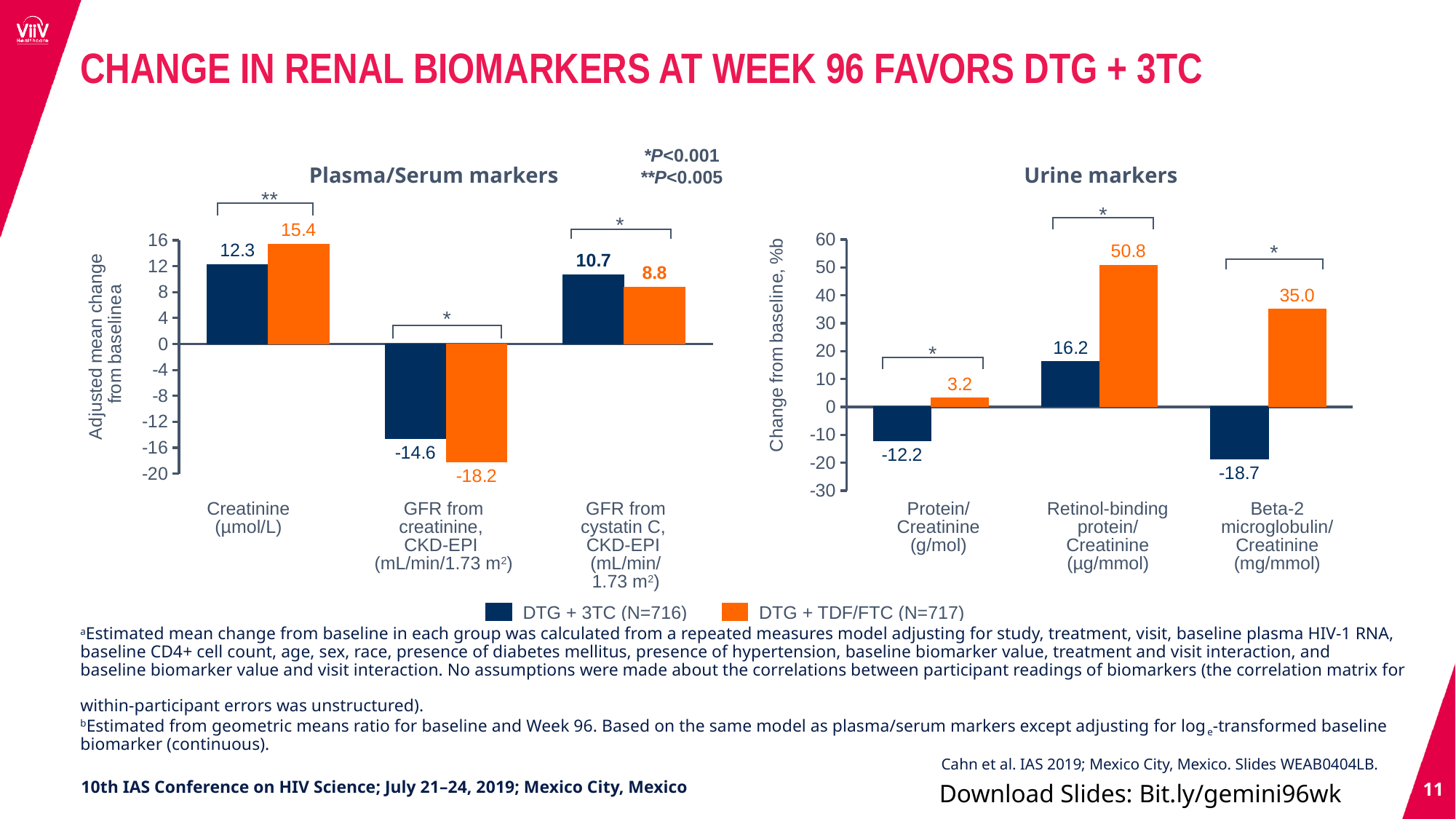
In the Plasma/Serum markers chart, what is the value for DTG + 3TC for Creatinine (µmol/L)? 12.3 In the Plasma/Serum markers chart, what is the value for DTG + TDF/FTC for GFR from creatinine, CKD-EPI? -18.2 In the Urine markers chart, what is the value for DTG + TDF/FTC for Retinol-binding protein/Creatinine? 50.8 In the Urine markers chart, which category has the highest DTG + TDF/FTC value? Retinol-binding protein/Creatinine In the Plasma/Serum markers chart, what is the difference between the DTG + TDF/FTC and DTG + 3TC values for Creatinine? 3.1 How many series does the legend list? 2 In the Urine markers chart, what is the difference between the DTG + TDF/FTC and DTG + 3TC values for Retinol-binding protein/Creatinine? 34.6 What kind of chart is the Plasma/Serum markers chart? Bar chart In the Plasma/Serum markers chart, which category has the lowest DTG + 3TC value? GFR from creatinine, CKD-EPI In the Plasma/Serum markers chart, which series has the larger value for GFR from cystatin C, CKD-EPI? DTG + 3TC In the Urine markers chart, what is the value for DTG + 3TC for Beta-2 microglobulin/Creatinine? -18.7 How many categories are shown in the Urine markers chart? 3